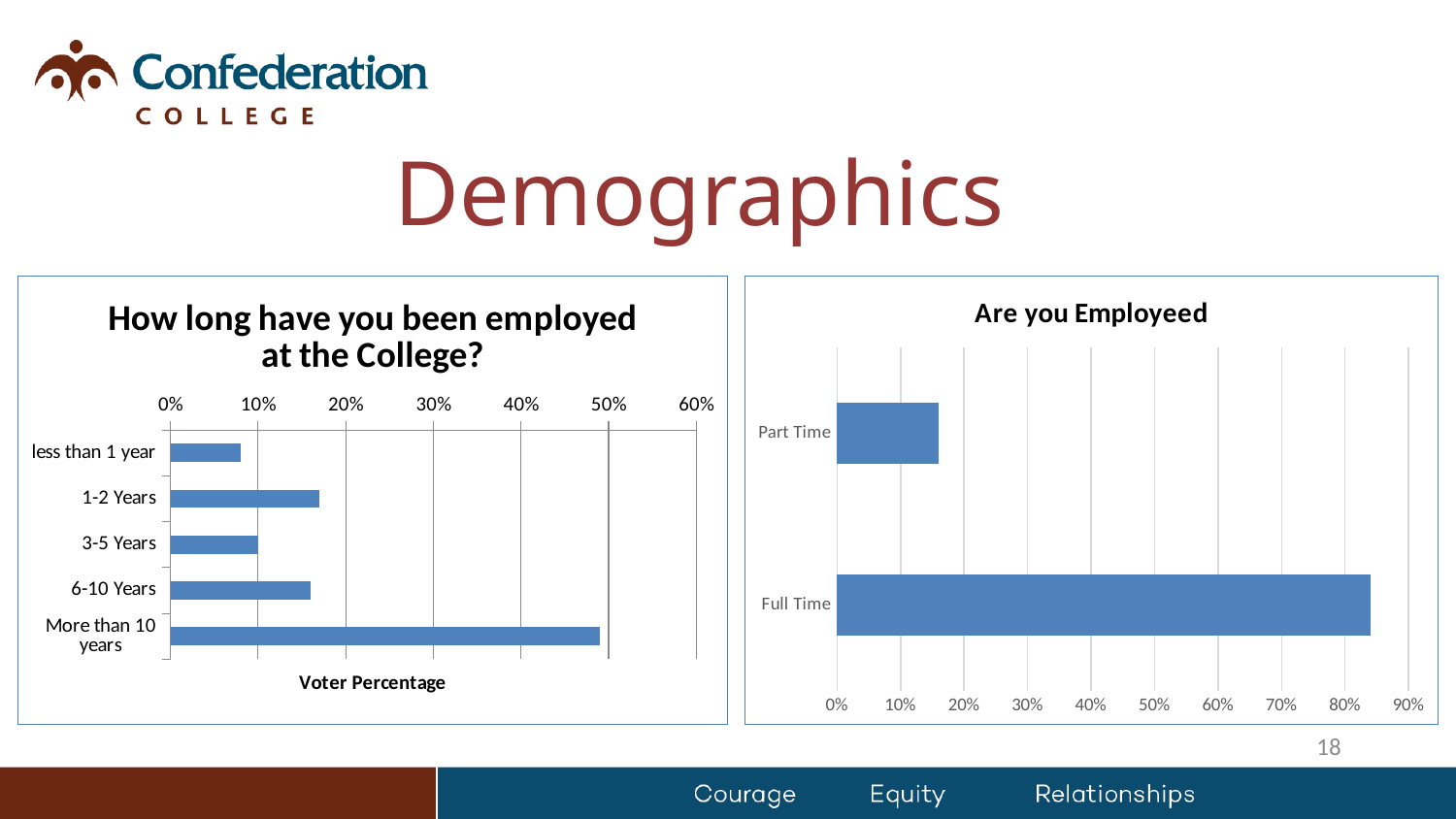
What kind of chart is the 'Are you Employeed' chart? bar chart In the 'How long have you been employed at the College?' chart, which is larger: the value for '1-2 Years' or '3-5 Years'? 1-2 Years What kind of chart is the 'How long have you been employed at the College?' chart? bar chart What is the x-axis title of the 'How long have you been employed at the College?' chart? Voter Percentage In the 'Are you Employeed' chart, which category has the highest value? Full Time In the 'How long have you been employed at the College?' chart, is the value for 'less than 1 year' greater or less than 10%? less In the 'How long have you been employed at the College?' chart, is the value for 'More than 10 years' greater or less than 40%? greater How many categories are shown in the 'How long have you been employed at the College?' chart? 5 In the 'How long have you been employed at the College?' chart, is the value for '1-2 Years' greater or less than 10%? greater In the 'How long have you been employed at the College?' chart, which category has the highest voter percentage? More than 10 years How many categories are shown in the 'Are you Employeed' chart? 2